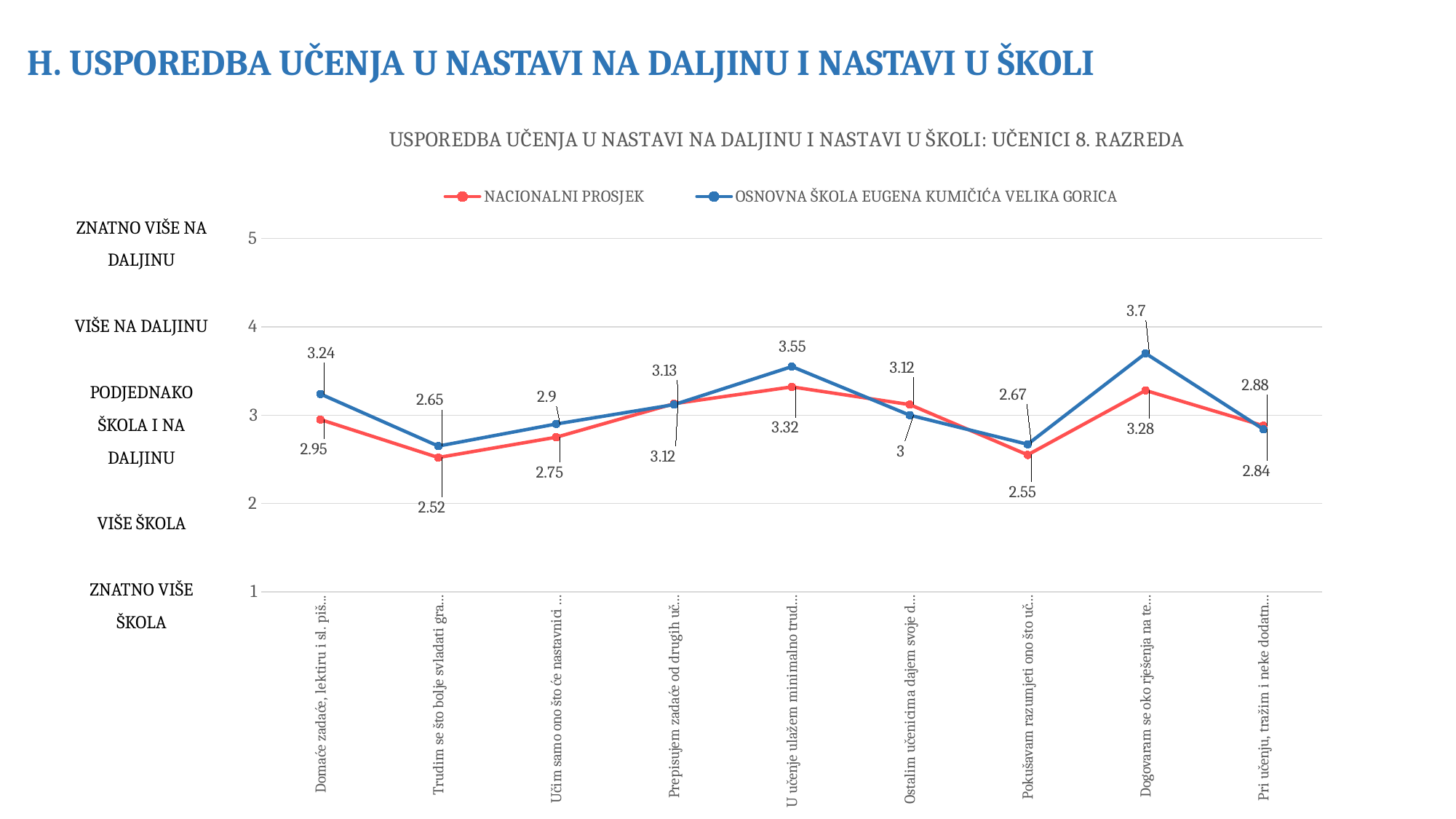
What is the difference between the OSNOVNA ŠKOLA EUGENA KUMIČIĆA VELIKA GORICA value and the NACIONALNI PROSJEK value for the category starting 'Dogovaram se oko rješenja na te...'? 0.42 For which category does OSNOVNA ŠKOLA EUGENA KUMIČIĆA VELIKA GORICA have its highest value? Dogovaram se oko rješenja na te... What colour is the line for NACIONALNI PROSJEK? red What is the NACIONALNI PROSJEK value for the last category (Pri učenju, tražim i neke dodatn...)? 2.88 What type of chart is shown on the slide? line chart What is the NACIONALNI PROSJEK value for the category starting 'U učenje ulažem minimalno trud...'? 3.32 Is the OSNOVNA ŠKOLA EUGENA KUMIČIĆA VELIKA GORICA value for the category starting 'Trudim se što bolje svladati gra...' greater or less than 3? less For the category starting 'Ostalim učenicima dajem svoje d...', which series has the larger value? NACIONALNI PROSJEK What is the lowest NACIONALNI PROSJEK value shown on the chart? 2.52 How many categories are plotted along the x axis? 9 What is the value for OSNOVNA ŠKOLA EUGENA KUMIČIĆA VELIKA GORICA for the first category (Domaće zadaće, lektiru i sl. piš...)? 3.24 How many series does the legend list? 2